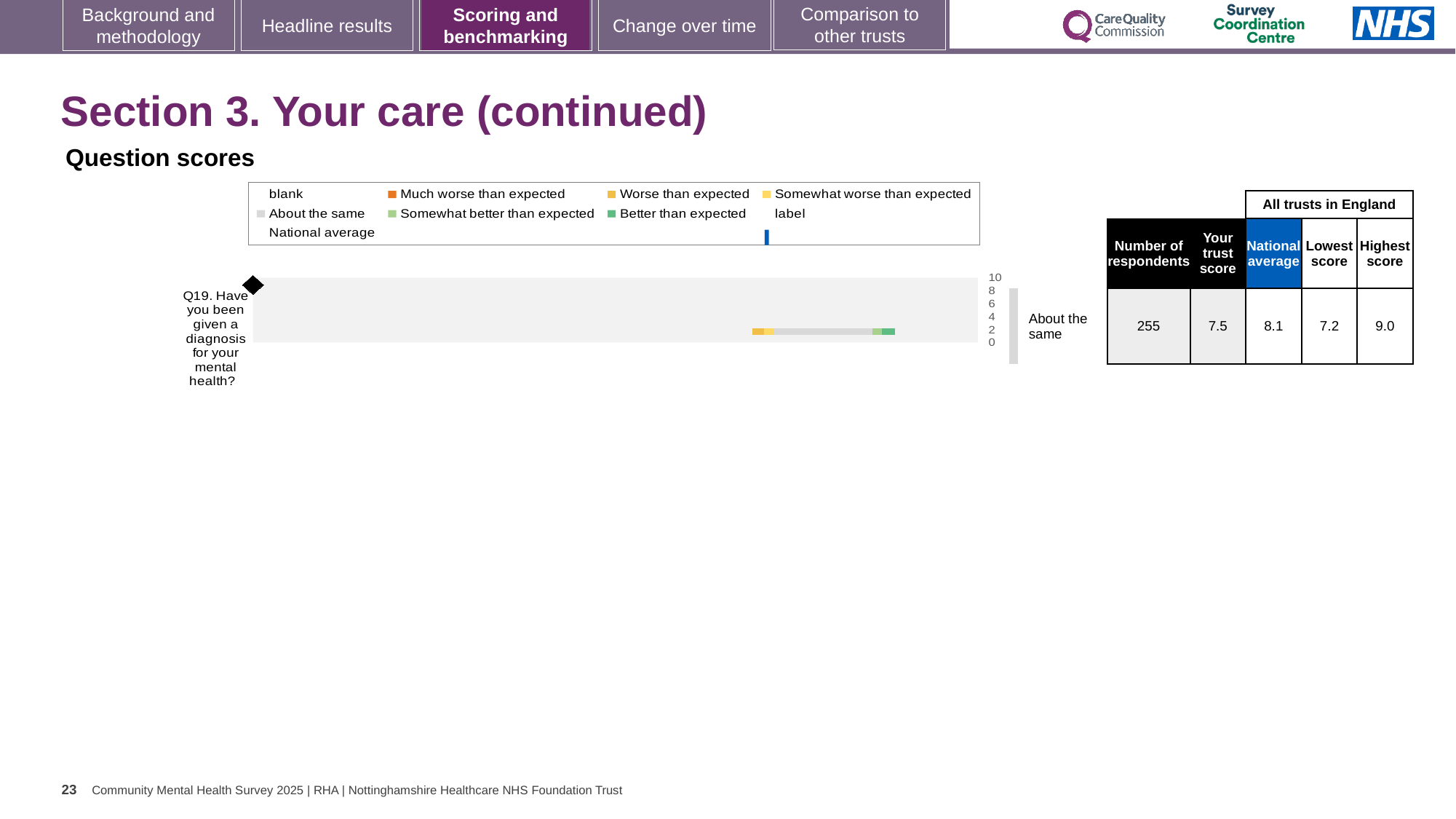
What is the highest score among all trusts in England for Q19? 9.0 What is the lowest score among all trusts in England for Q19? 7.2 What is the trust score for Q19 (Have you been given a diagnosis for your mental health?)? 7.5 Which is larger for Q19, the trust score or the national average? national average What benchmark category is shown next to the Q19 bar? About the same What is the number of respondents for Q19? 255 What is the difference between the national average and the trust score for Q19? 0.6 Is the trust score for Q19 greater or less than 8? less What is the difference between the highest and lowest scores for Q19 across all trusts in England? 1.8 What is the national average score for Q19? 8.1 How many questions are plotted on the chart? 1 What type of chart is used to show the Q19 question score? bar chart